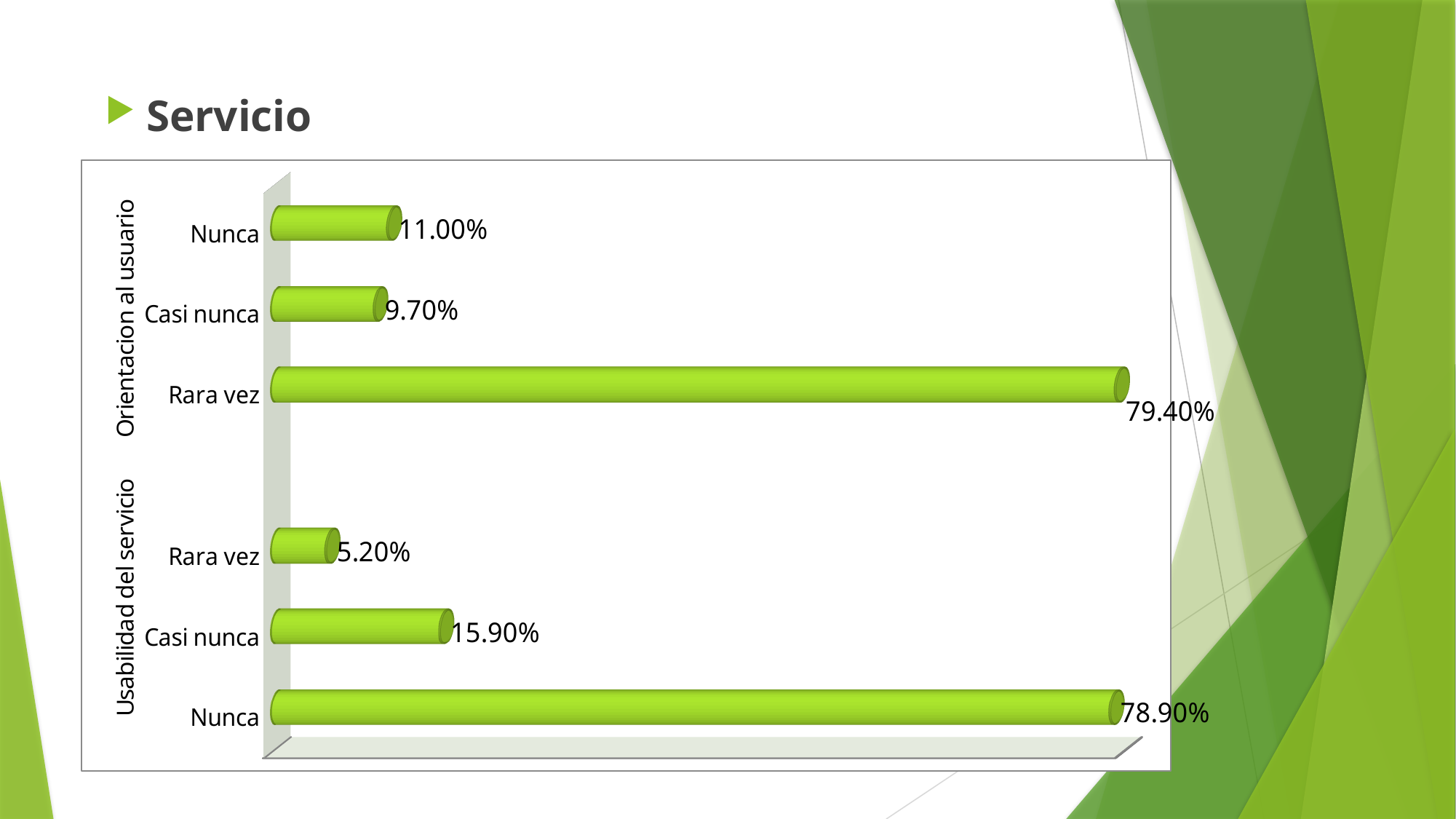
What kind of chart is shown on the slide? Bar chart What is the value for "Rara vez" under "Orientacion al usuario"? 79.40% How many bars are plotted in the chart? 6 What is the value for "Nunca" under "Usabilidad del servicio"? 78.90% What is the value for "Casi nunca" under "Orientacion al usuario"? 9.70% What are the two group labels shown on the vertical axis of the chart? Orientacion al usuario and Usabilidad del servicio Which is larger: "Nunca" under "Orientacion al usuario" or "Nunca" under "Usabilidad del servicio"? Nunca under Usabilidad del servicio What is the difference between "Rara vez" under "Orientacion al usuario" and "Nunca" under "Usabilidad del servicio"? 0.50% Which category has the lowest value in the chart? Rara vez (Usabilidad del servicio) What is the value for "Rara vez" under "Usabilidad del servicio"? 5.20% What is the difference between "Casi nunca" under "Usabilidad del servicio" and "Casi nunca" under "Orientacion al usuario"? 6.20% Which category has the highest value in the chart? Rara vez (Orientacion al usuario)